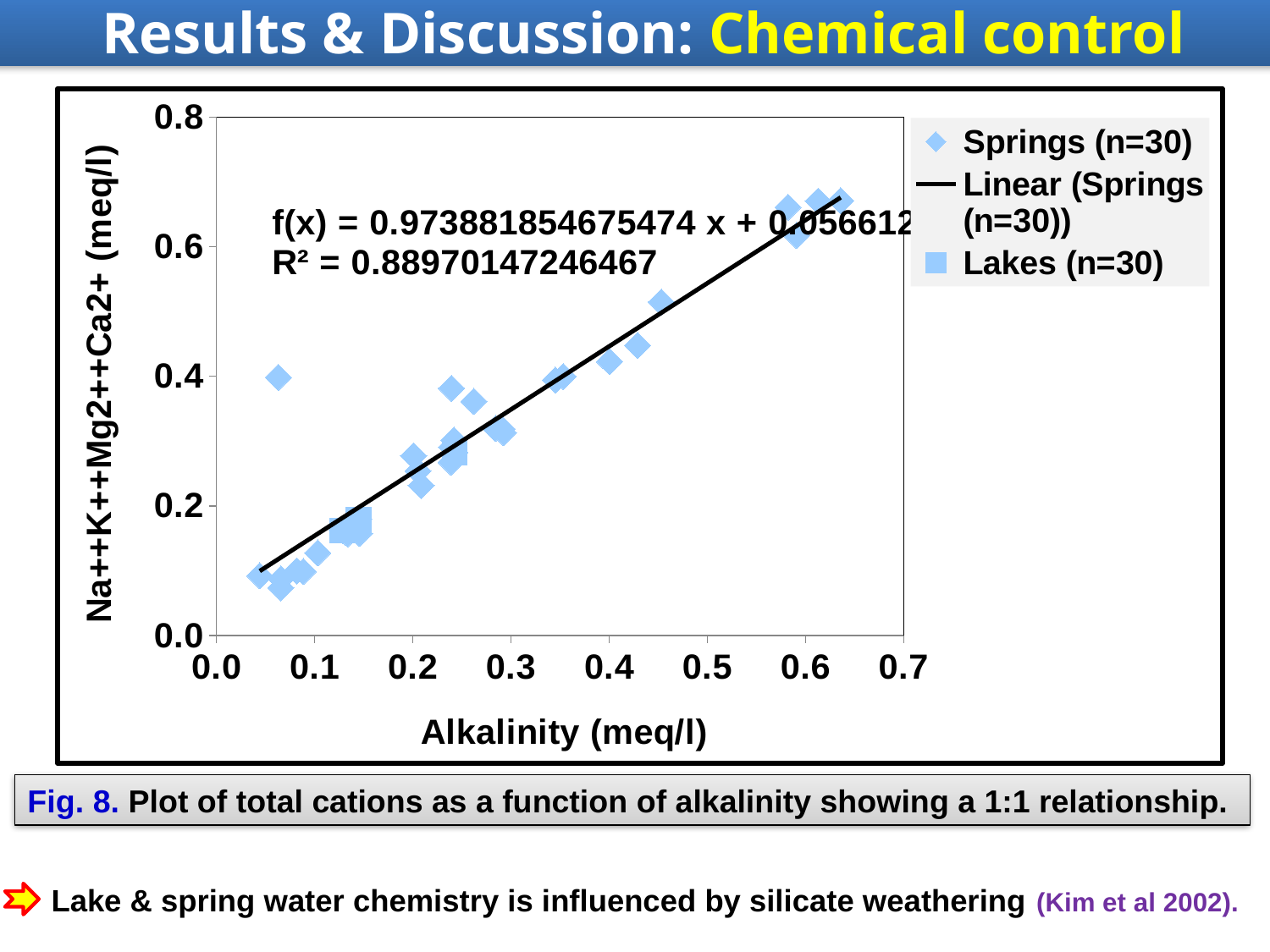
Is the lowest plotted total cation value greater or less than 0.2? less Is the highest plotted total cation value greater or less than 0.6? greater What is the R² value printed on the chart? 0.88970147246467 How many entries does the chart legend list? 3 Do the total cation values rise or fall as alkalinity increases along the x axis? rise How many lakes samples does the legend say were plotted? 30 What is the label of the x axis? Alkalinity (meq/l) How many springs samples does the legend say were plotted? 30 What is the label of the y axis? Na++K++Mg2++Ca2+ (meq/l) What is the equation of the fitted line printed on the chart? f(x) = 0.973881854675474 x + 0.056612 What kind of chart is shown on the slide? scatter chart What is the maximum value shown on the x axis? 0.7